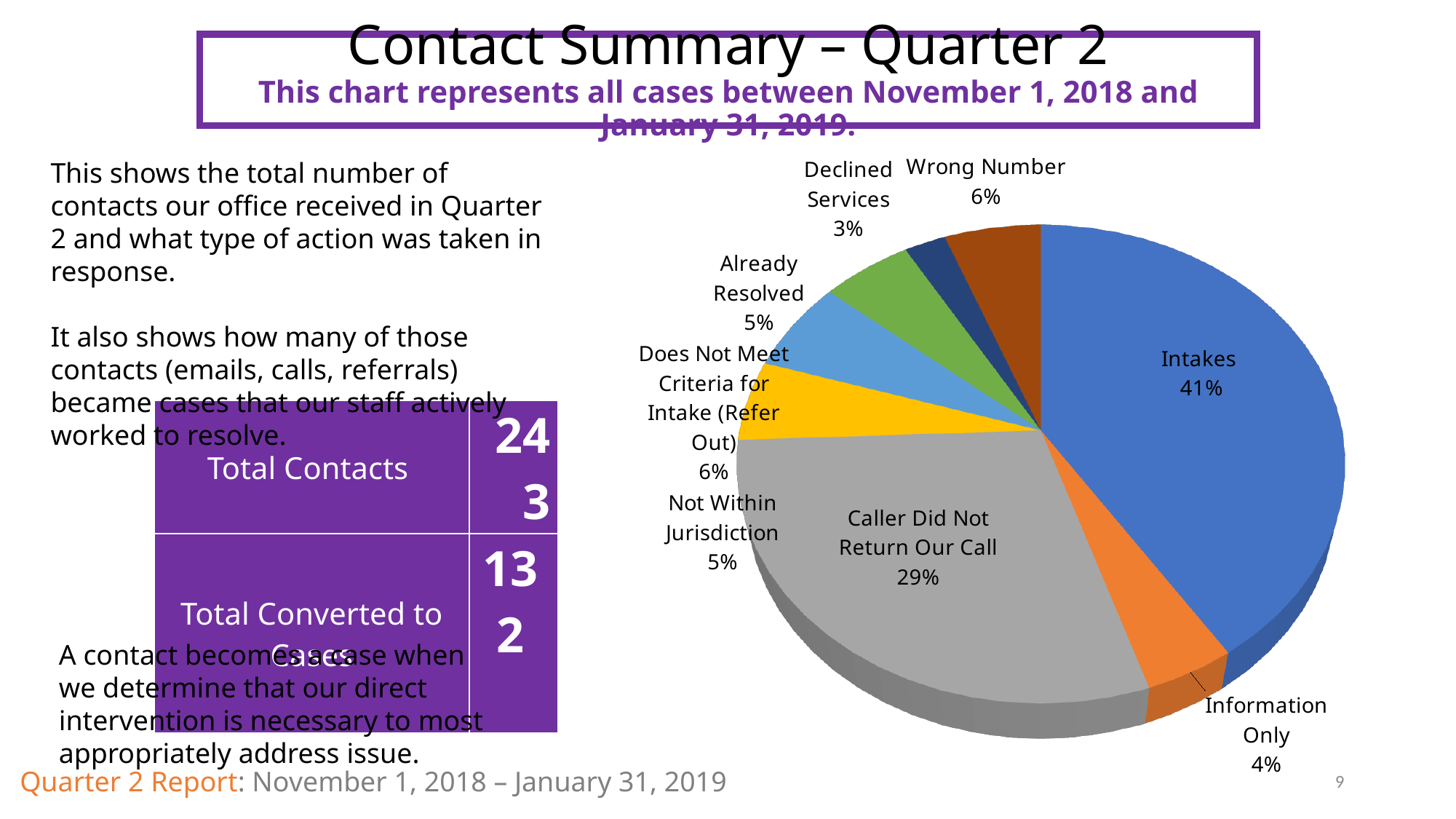
Which is larger, the share for Already Resolved or the share for Wrong Number? Wrong Number What percentage is shown for Information Only? 4% What percentage is shown for Wrong Number? 6% Which category has the largest slice of the pie? Intakes What percentage is shown for Declined Services? 3% What colour is the Intakes slice? blue How many slices does the pie chart have? 8 What share of the pie does Intakes represent? 41% Which category has the smallest slice of the pie? Declined Services What type of chart is shown on the slide? pie chart What percentage is shown for Caller Did Not Return Our Call? 29% What is the difference in percentage points between Intakes and Caller Did Not Return Our Call? 12